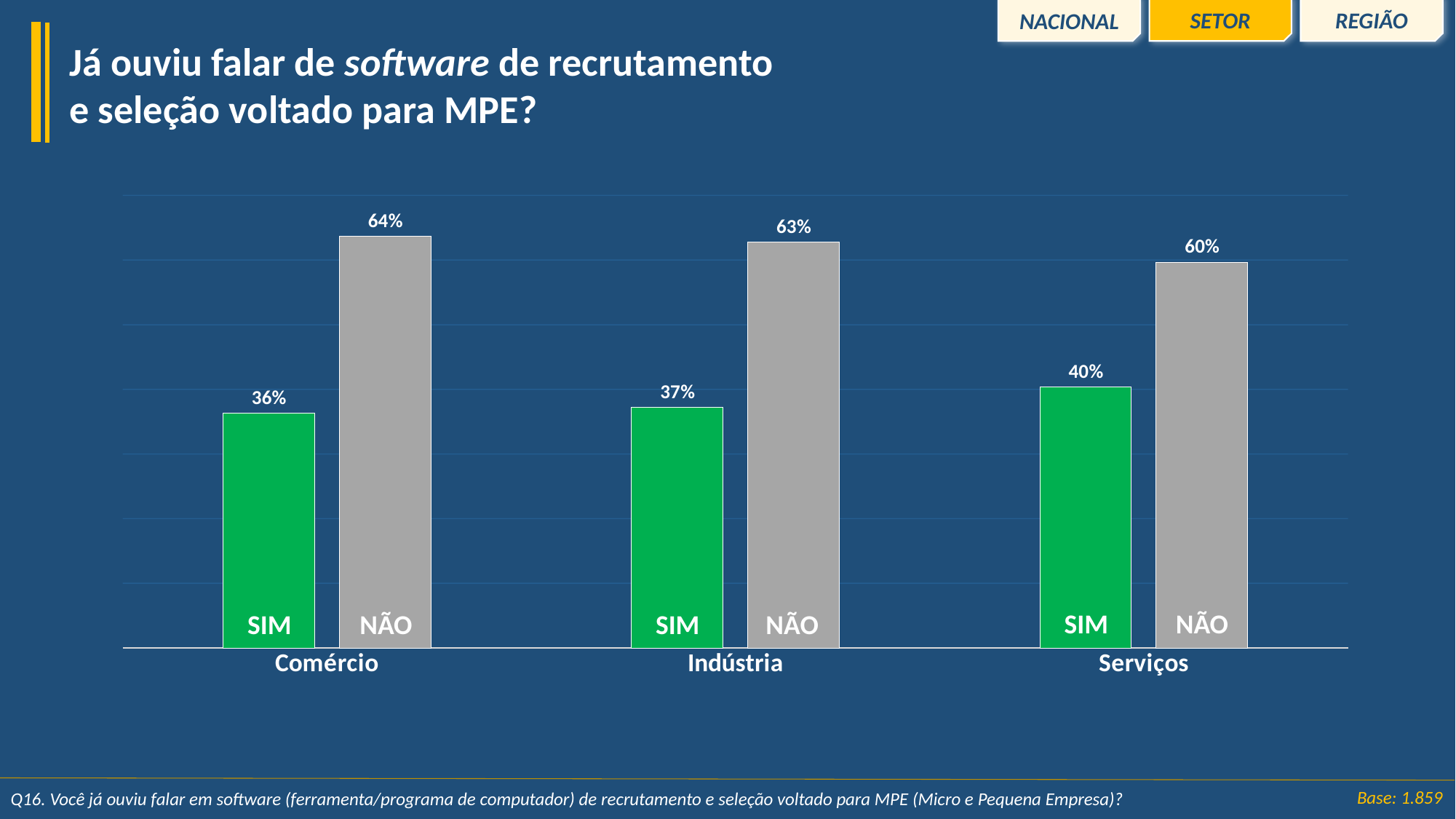
What is the NÃO value for Indústria? 63% Which sector has the lowest NÃO value? Serviços What is the difference between the NÃO and SIM values for Comércio? 28% Which is larger for Indústria, SIM or NÃO? NÃO How many sectors are shown on the x axis? 3 Which sector has the highest SIM value? Serviços What is the NÃO value for Serviços? 60% What is the SIM value for Serviços? 40% What colour are the SIM bars? Green What kind of chart is shown on the slide? Bar chart How many series (SIM and NÃO) are plotted for each sector? 2 What is the SIM value for Comércio? 36%